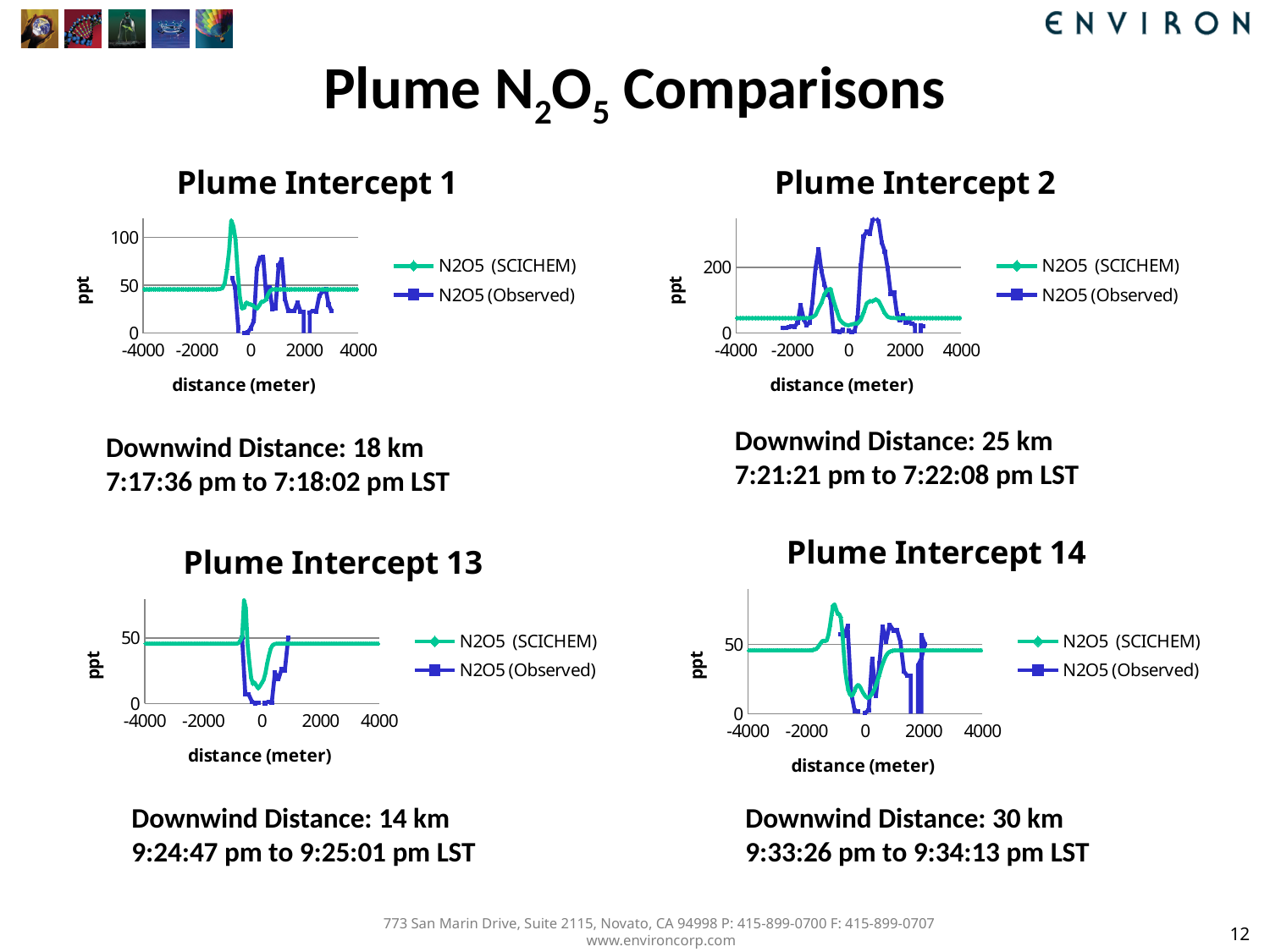
What is the y-axis label of the Plume Intercept 14 chart? ppt In Plume Intercept 2, which series reaches the higher peak, N2O5 (SCICHEM) or N2O5 (Observed)? N2O5 (Observed) What kind of chart is Plume Intercept 1? line chart In Plume Intercept 2, is the peak value of N2O5 (SCICHEM) greater or less than 200? less How many series does the legend of Plume Intercept 2 list? 2 In Plume Intercept 2, is the peak value of N2O5 (Observed) greater or less than 200? greater In Plume Intercept 1, which series reaches the higher peak, N2O5 (SCICHEM) or N2O5 (Observed)? N2O5 (SCICHEM) How many charts are shown on the slide? 4 In Plume Intercept 1, is the peak value of N2O5 (Observed) greater or less than 100? less What is the x-axis label of the Plume Intercept 13 chart? distance (meter)